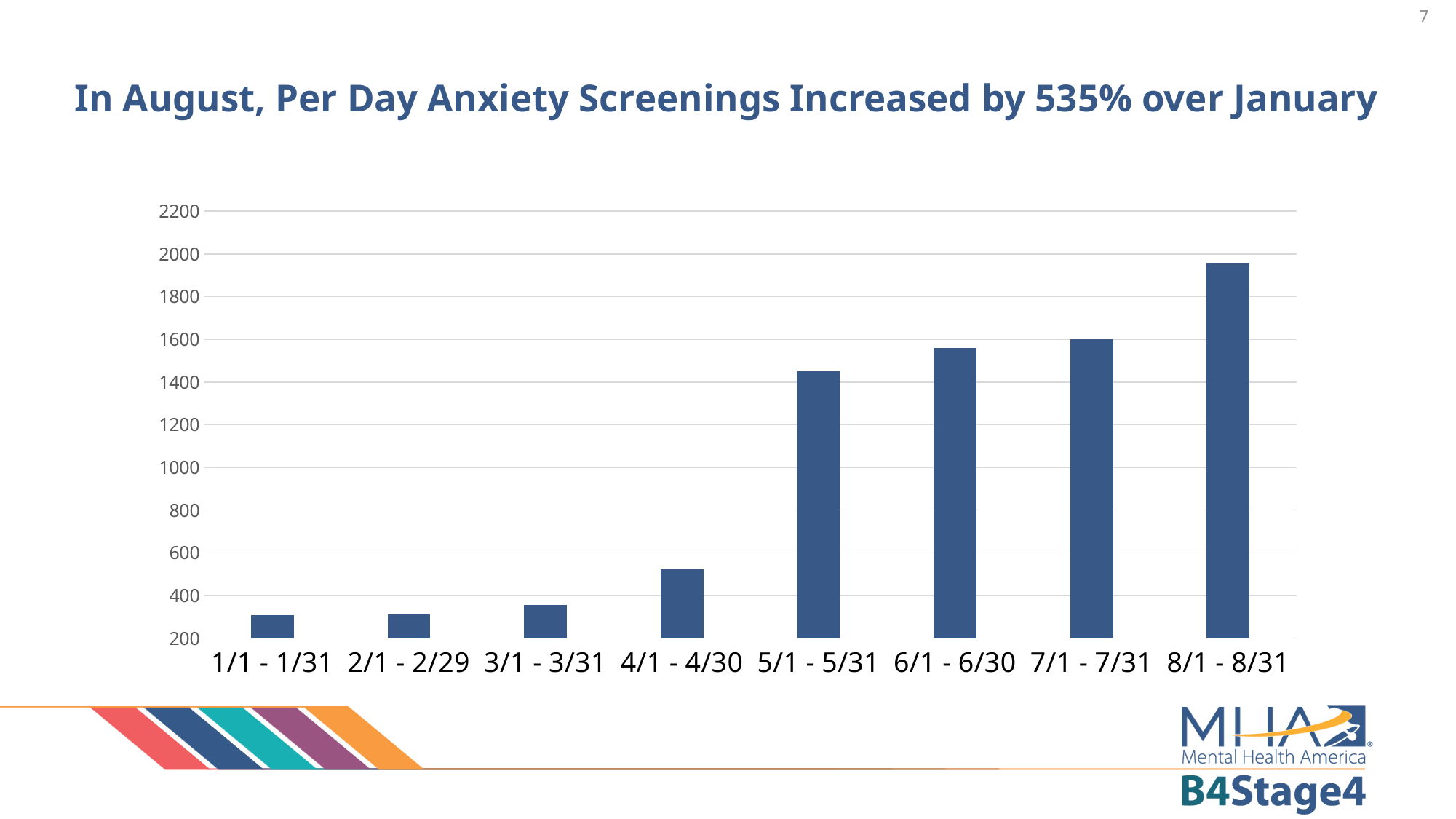
Is the value for 8/1 - 8/31 greater or less than 1800? greater Is the value for 4/1 - 4/30 greater or less than 600? less Is the value for 3/1 - 3/31 greater or less than 400? less Do the values generally rise or fall from 1/1 - 1/31 to 8/1 - 8/31? rise Which is larger, the value for 6/1 - 6/30 or the value for 8/1 - 8/31? 8/1 - 8/31 What kind of chart is shown on the slide? bar chart How many date-range categories are shown on the x axis? 8 Which is larger, the value for 4/1 - 4/30 or the value for 5/1 - 5/31? 5/1 - 5/31 Which date range has the highest bar? 8/1 - 8/31 What is the title of the slide? In August, Per Day Anxiety Screenings Increased by 535% over January